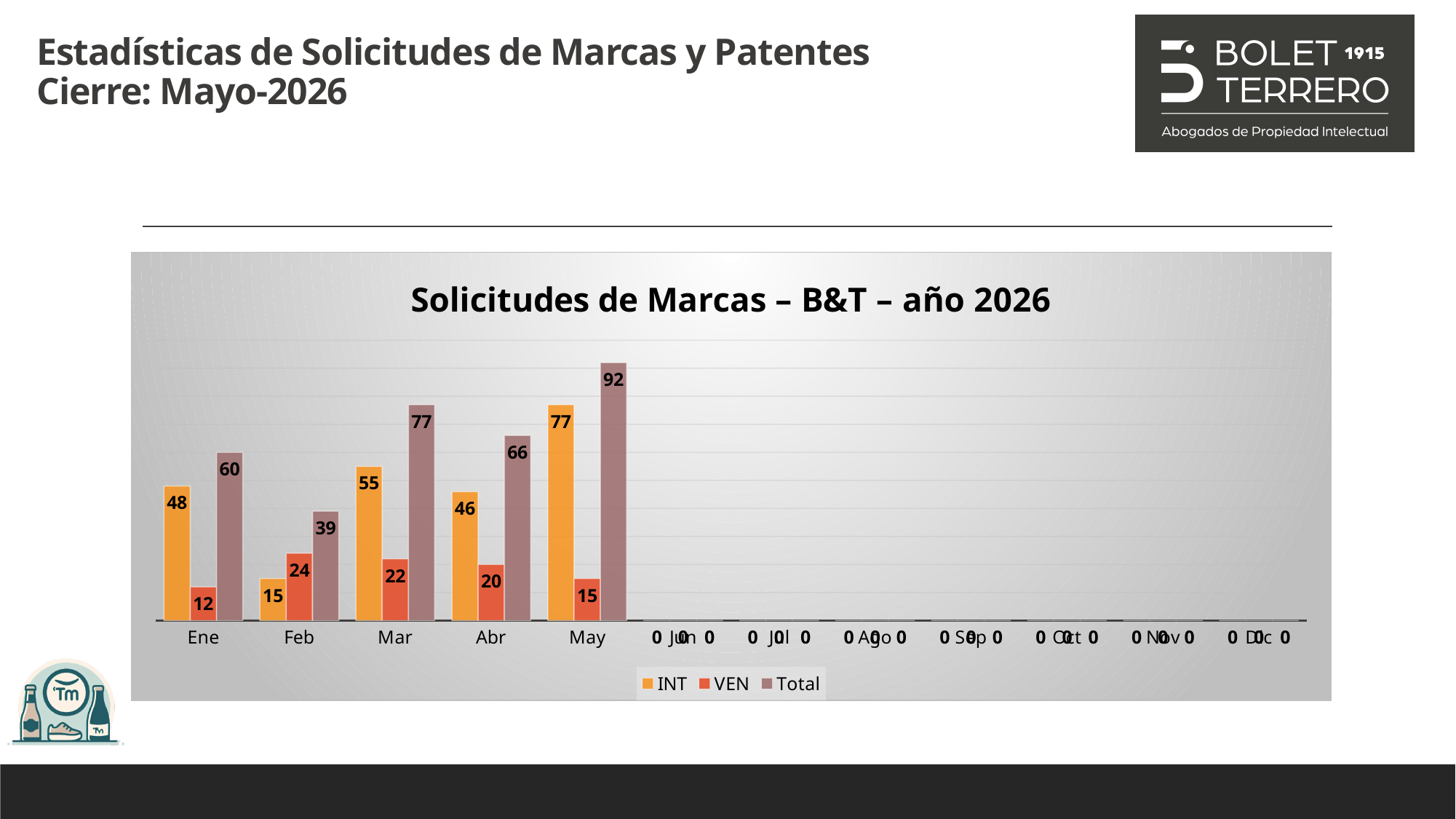
What is the VEN value for Feb in the chart? 24 Among the months Ene to May, which has the lowest INT value? Feb What is the VEN value for Jun in the chart? 0 What is the title of the chart? Solicitudes de Marcas – B&T – año 2026 What kind of chart is shown on the slide? Bar chart Which month has the highest Total value in the chart? May What is the INT value for Mar in the chart? 55 How many series does the legend list? 3 Which is larger, the INT value for Ene or the INT value for Abr? INT value for Ene How many months are shown on the x axis of the chart? 12 What is the Total value for May in the chart? 92 What is the difference between the Total values for Mar and Feb? 38